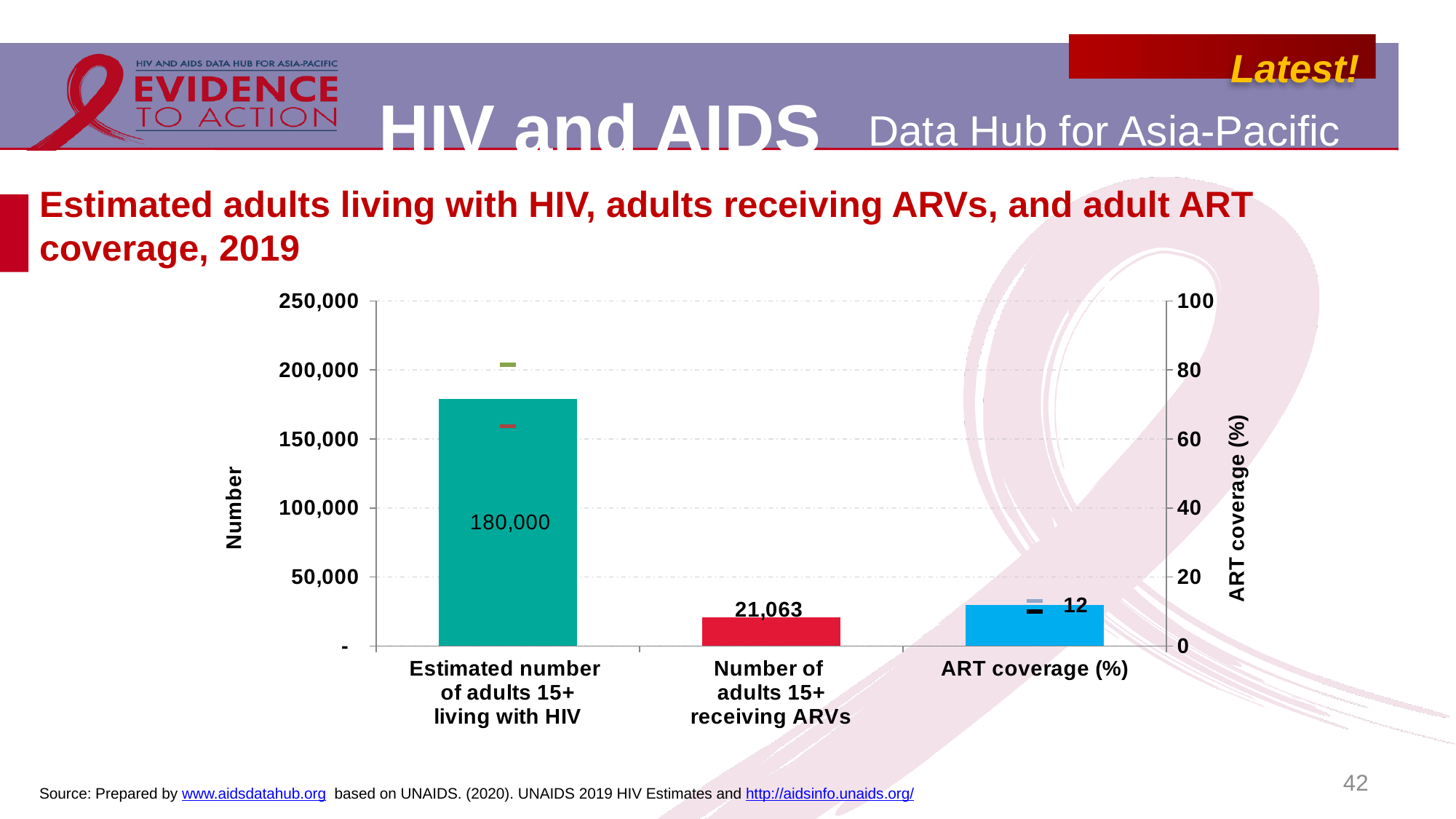
Which is larger: the estimated number of adults 15+ living with HIV or the number of adults 15+ receiving ARVs? Estimated number of adults 15+ living with HIV Which category has the tallest bar on the chart? Estimated number of adults 15+ living with HIV What kind of chart is shown on the slide? Bar chart Is the value for the number of adults 15+ receiving ARVs greater or less than 50,000? less What is the label of the left vertical axis of the chart? Number What is the ART coverage (%) value shown on the chart? 12 Is the value for the estimated number of adults 15+ living with HIV greater or less than 150,000? greater What is the number of adults 15+ receiving ARVs shown on the chart? 21,063 What is the difference between the estimated number of adults 15+ living with HIV and the number of adults 15+ receiving ARVs? 158,937 What is the estimated number of adults 15+ living with HIV shown on the chart? 180,000 What is the label of the right vertical axis of the chart? ART coverage (%) How many categories are shown on the x axis of the chart? 3